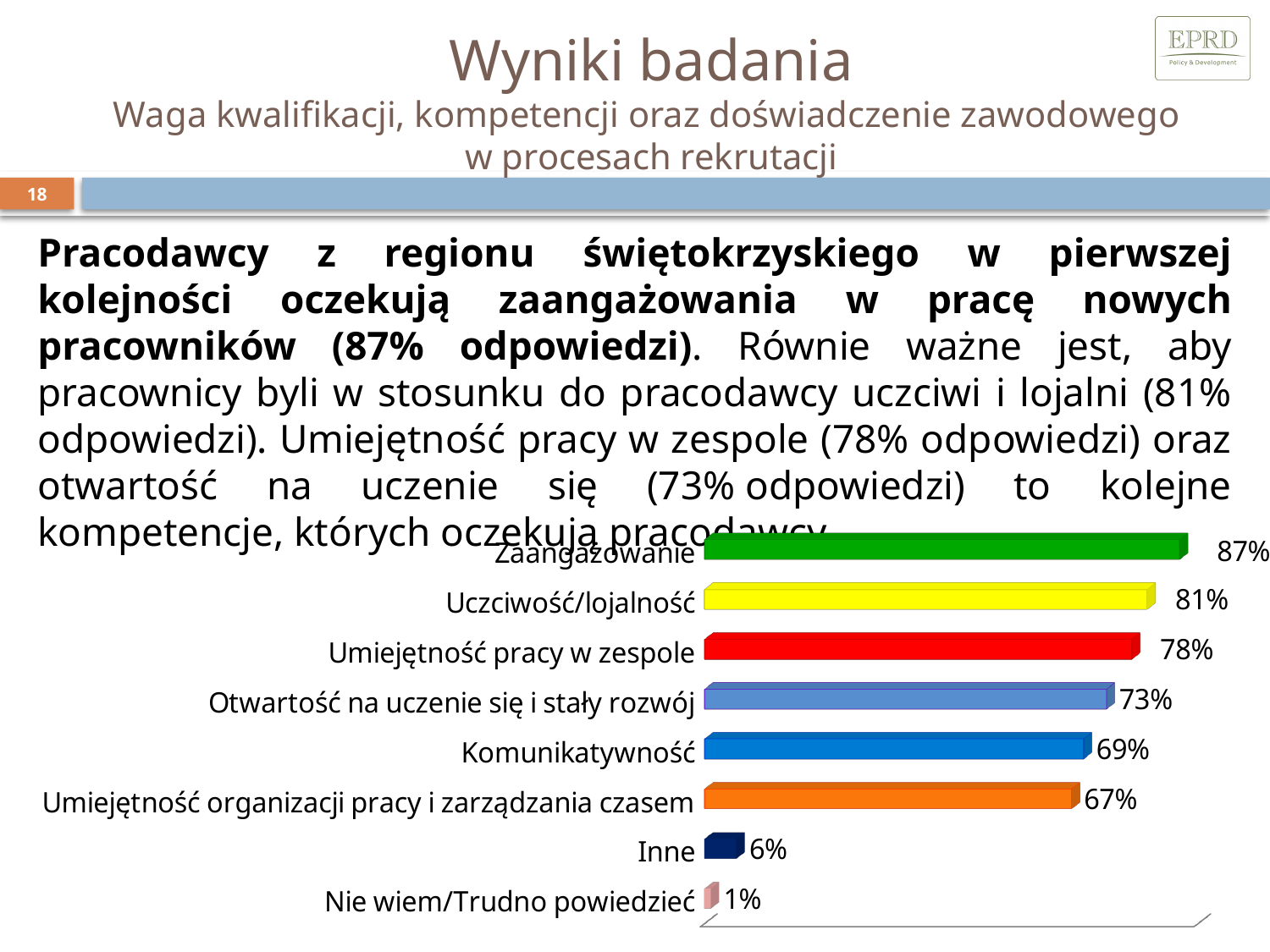
What is the difference between the values for Umiejętność pracy w zespole and Otwartość na uczenie się i stały rozwój? 5% Which category has the highest value? Zaangażowanie What is the value for Umiejętność organizacji pracy i zarządzania czasem? 67% How many categories are shown in the chart? 8 What is the difference between the values for Zaangażowanie and Uczciwość/lojalność? 6% What is the value for Uczciwość/lojalność? 81% What colour is the bar for Umiejętność pracy w zespole? Red What kind of chart is shown on the slide? Bar chart Which category has the lowest value? Nie wiem/Trudno powiedzieć What is the value for Zaangażowanie? 87% Which is larger, the value for Komunikatywność or the value for Inne? Komunikatywność What is the value for Komunikatywność? 69%